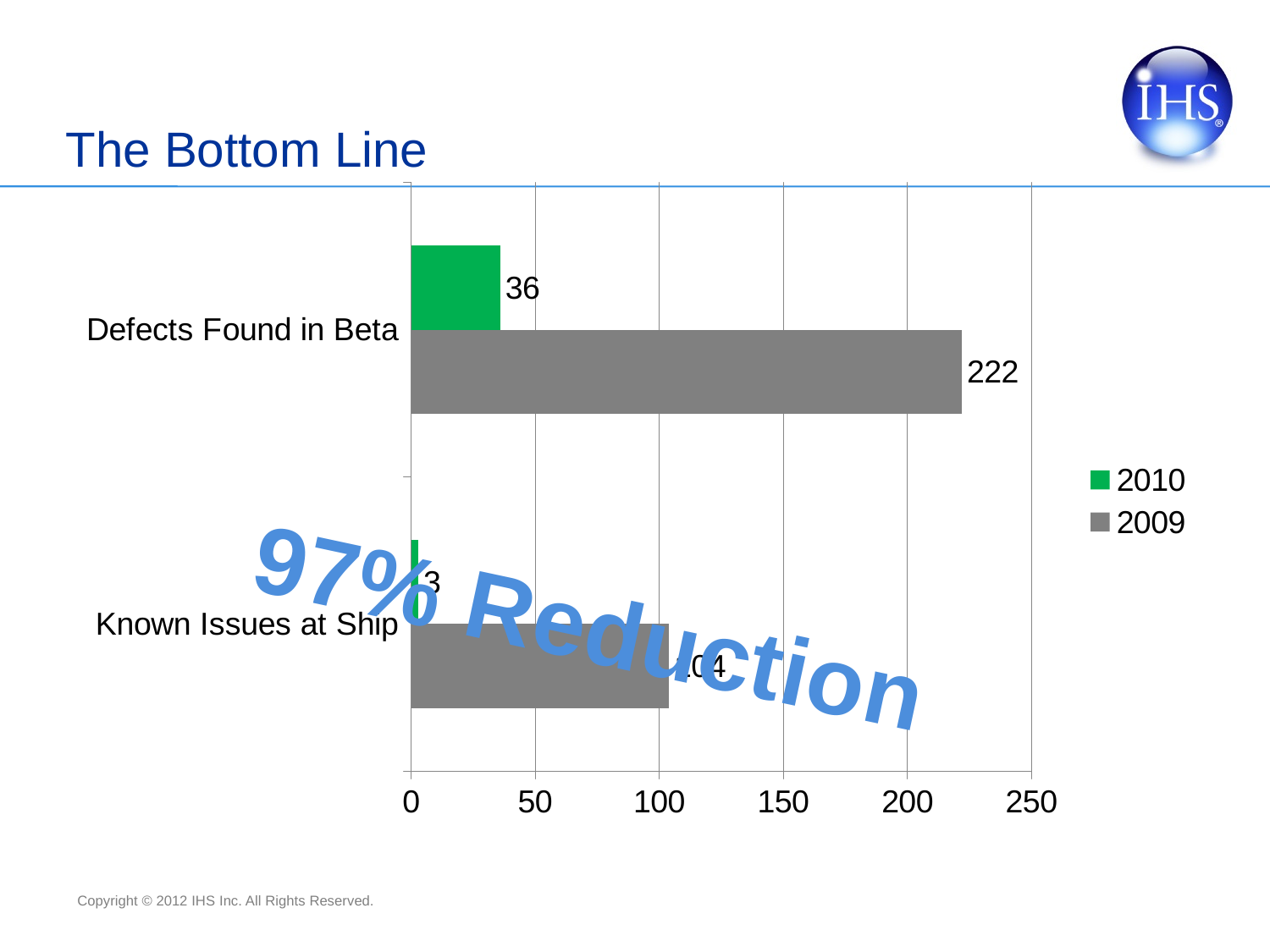
What colour represents the 2010 series in the legend? green What is the 2009 value for Defects Found in Beta? 222 What kind of chart is shown on the slide? bar chart What is the difference between the 2009 and 2010 values for Defects Found in Beta? 186 How many categories are shown on the chart? 2 What is the 2010 value for Defects Found in Beta? 36 Is the 2009 value for Known Issues at Ship greater or less than 150? less What is the 2010 value for Known Issues at Ship? 3 How many series does the legend list? 2 For Defects Found in Beta, which series has the larger value, 2009 or 2010? 2009 Which category and series has the lowest value in the chart? Known Issues at Ship, 2010 Which category and series has the highest value in the chart? Defects Found in Beta, 2009